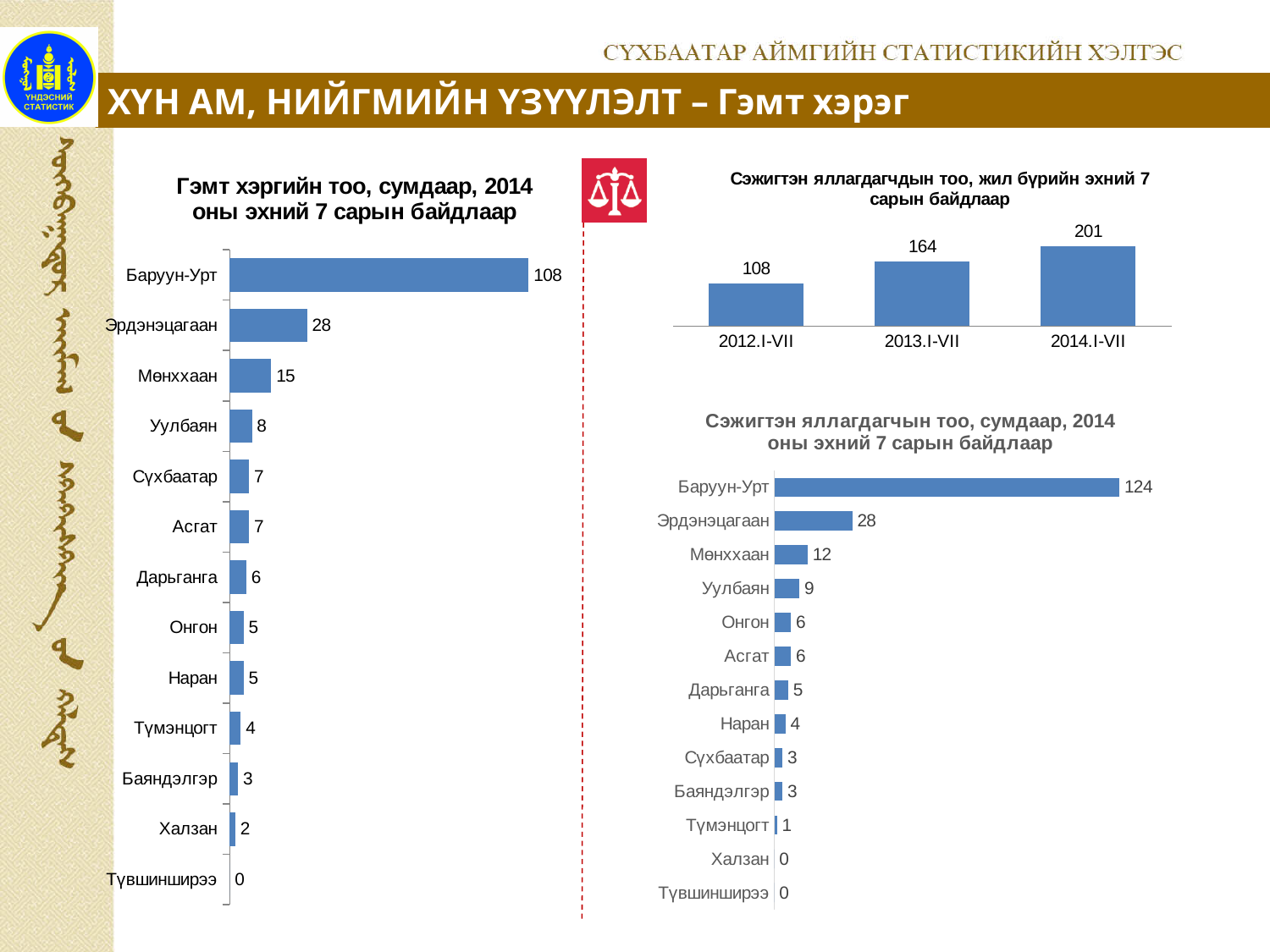
In the chart titled "Сэжигтэн яллагдагчдын тоо, жил бүрийн эхний 7 сарын байдлаар", what is the difference between 2014.I-VII and 2012.I-VII? 93 In the chart titled "Гэмт хэргийн тоо, сумдаар, 2014 оны эхний 7 сарын байдлаар", what is the value for Мөнххаан? 15 In the chart titled "Гэмт хэргийн тоо, сумдаар, 2014 оны эхний 7 сарын байдлаар", which category has the lowest value? Түвшинширээ In the chart titled "Гэмт хэргийн тоо, сумдаар, 2014 оны эхний 7 сарын байдлаар", what is the difference between Баруун-Урт and Эрдэнэцагаан? 80 In the chart titled "Сэжигтэн яллагдагчдын тоо, жил бүрийн эхний 7 сарын байдлаар", do the values rise or fall from 2012.I-VII to 2014.I-VII? rise In the chart titled "Сэжигтэн яллагдагчын тоо, сумдаар, 2014 оны эхний 7 сарын байдлаар", what is the value for Түмэнцогт? 1 In the chart titled "Гэмт хэргийн тоо, сумдаар, 2014 оны эхний 7 сарын байдлаар", what is the value for Баруун-Урт? 108 How many categories are shown in the chart titled "Гэмт хэргийн тоо, сумдаар, 2014 оны эхний 7 сарын байдлаар"? 13 In the chart titled "Сэжигтэн яллагдагчын тоо, сумдаар, 2014 оны эхний 7 сарын байдлаар", what is the value for Баруун-Урт? 124 What kind of chart is the one titled "Сэжигтэн яллагдагчдын тоо, жил бүрийн эхний 7 сарын байдлаар"? bar chart In the chart titled "Сэжигтэн яллагдагчын тоо, сумдаар, 2014 оны эхний 7 сарын байдлаар", which is larger, Уулбаян or Дарьганга? Уулбаян In the chart titled "Сэжигтэн яллагдагчдын тоо, жил бүрийн эхний 7 сарын байдлаар", what is the value for 2013.I-VII? 164